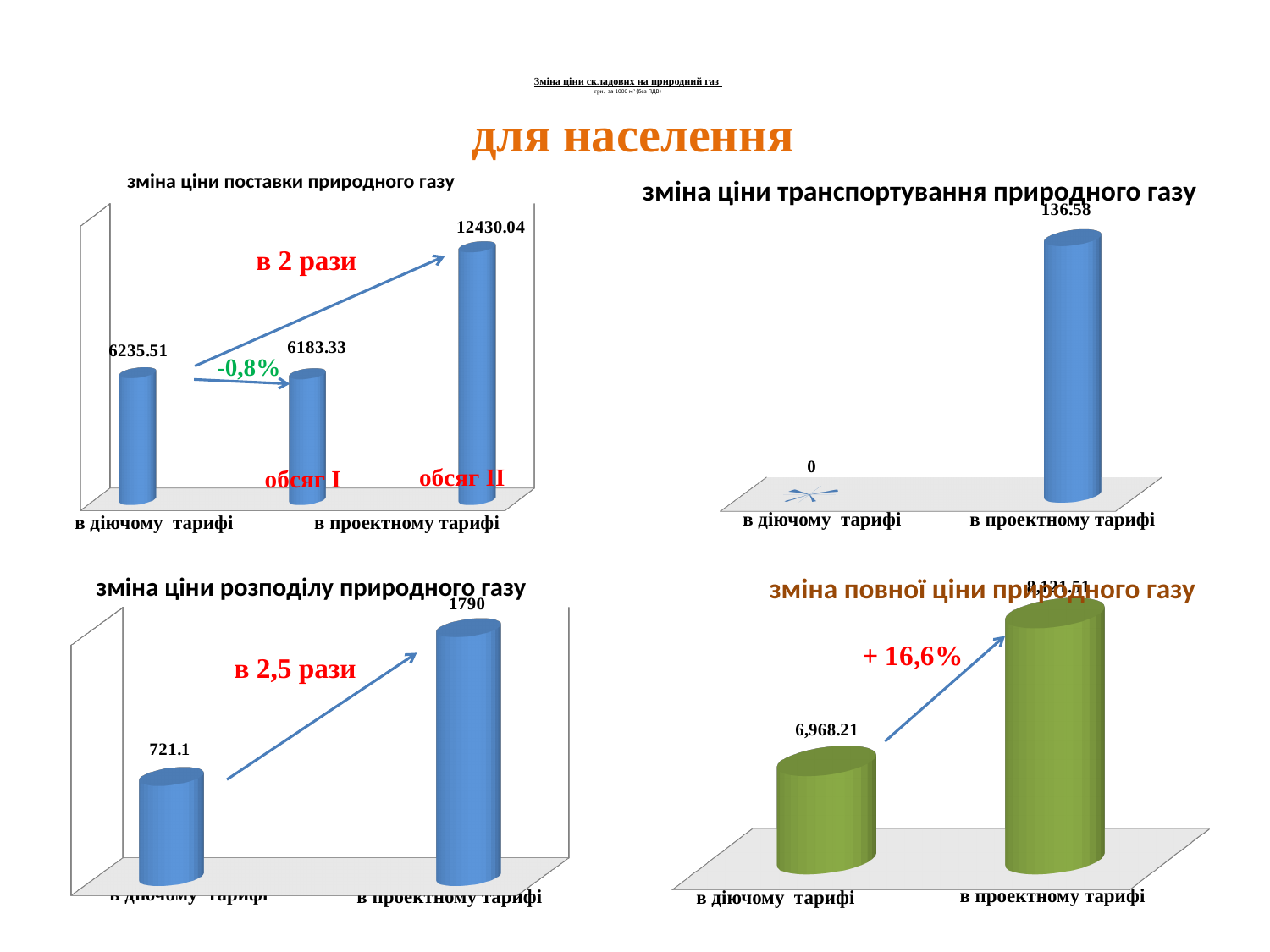
In the chart 'зміна ціни поставки природного газу', what is the value for 'в діючому тарифі'? 6235.51 In the chart 'зміна ціни поставки природного газу', which bar is the highest? обсяг II (в проектному тарифі) In the chart 'зміна ціни поставки природного газу', what is the value labelled 'обсяг II'? 12430.04 In the chart 'зміна ціни транспортування природного газу', what is the value for 'в діючому тарифі'? 0 In the chart 'зміна повної ціни природного газу', which is larger: 'в діючому тарифі' or 'в проектному тарифі'? в проектному тарифі In the chart 'зміна ціни розподілу природного газу', what is the value for 'в проектному тарифі'? 1790 In the chart 'зміна ціни транспортування природного газу', what is the value for 'в проектному тарифі'? 136.58 In the chart 'зміна ціни розподілу природного газу', what is the value for 'в діючому тарифі'? 721.1 In the chart 'зміна ціни розподілу природного газу', what is the difference between the 'в проектному тарифі' and 'в діючому тарифі' values? 1068.9 In the chart 'зміна ціни поставки природного газу', how many bars are plotted? 3 In the chart 'зміна ціни поставки природного газу', what is the value labelled 'обсяг I'? 6183.33 In the chart 'зміна повної ціни природного газу', what is the value for 'в діючому тарифі'? 6,968.21